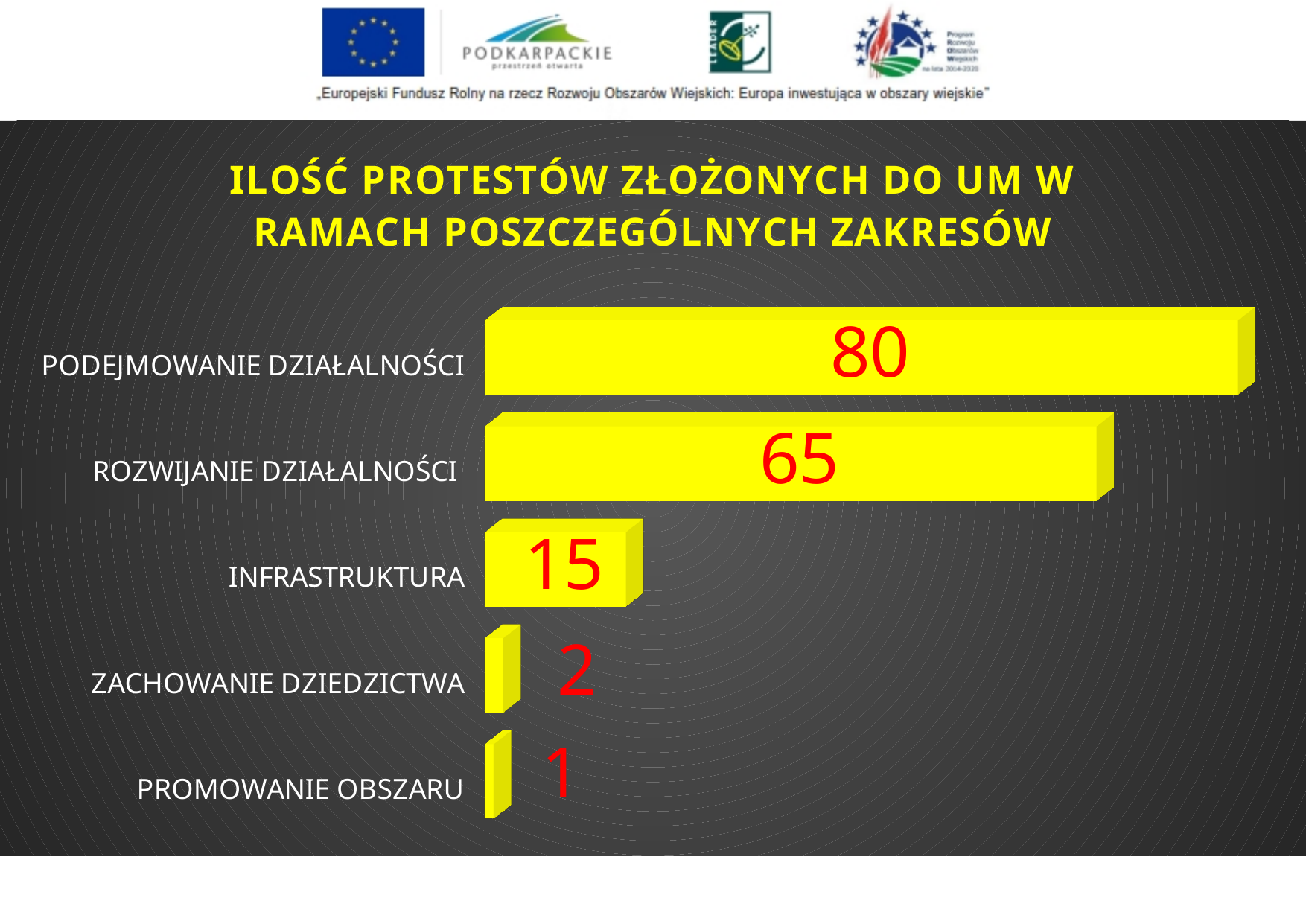
What is the value for PROMOWANIE OBSZARU? 1 Which is larger, the value for INFRASTRUKTURA or the value for ZACHOWANIE DZIEDZICTWA? INFRASTRUKTURA What is the value for ZACHOWANIE DZIEDZICTWA? 2 What is the value for ROZWIJANIE DZIAŁALNOŚCI? 65 What is the difference between the values for PODEJMOWANIE DZIAŁALNOŚCI and ROZWIJANIE DZIAŁALNOŚCI? 15 How many categories are shown in the chart? 5 Which category has the highest value? PODEJMOWANIE DZIAŁALNOŚCI What is the value for INFRASTRUKTURA? 15 What is the value for PODEJMOWANIE DZIAŁALNOŚCI? 80 Which category has the lowest value? PROMOWANIE OBSZARU What is the title of the chart? ILOŚĆ PROTESTÓW ZŁOŻONYCH DO UM W RAMACH POSZCZEGÓLNYCH ZAKRESÓW What kind of chart is shown on the slide? Bar chart